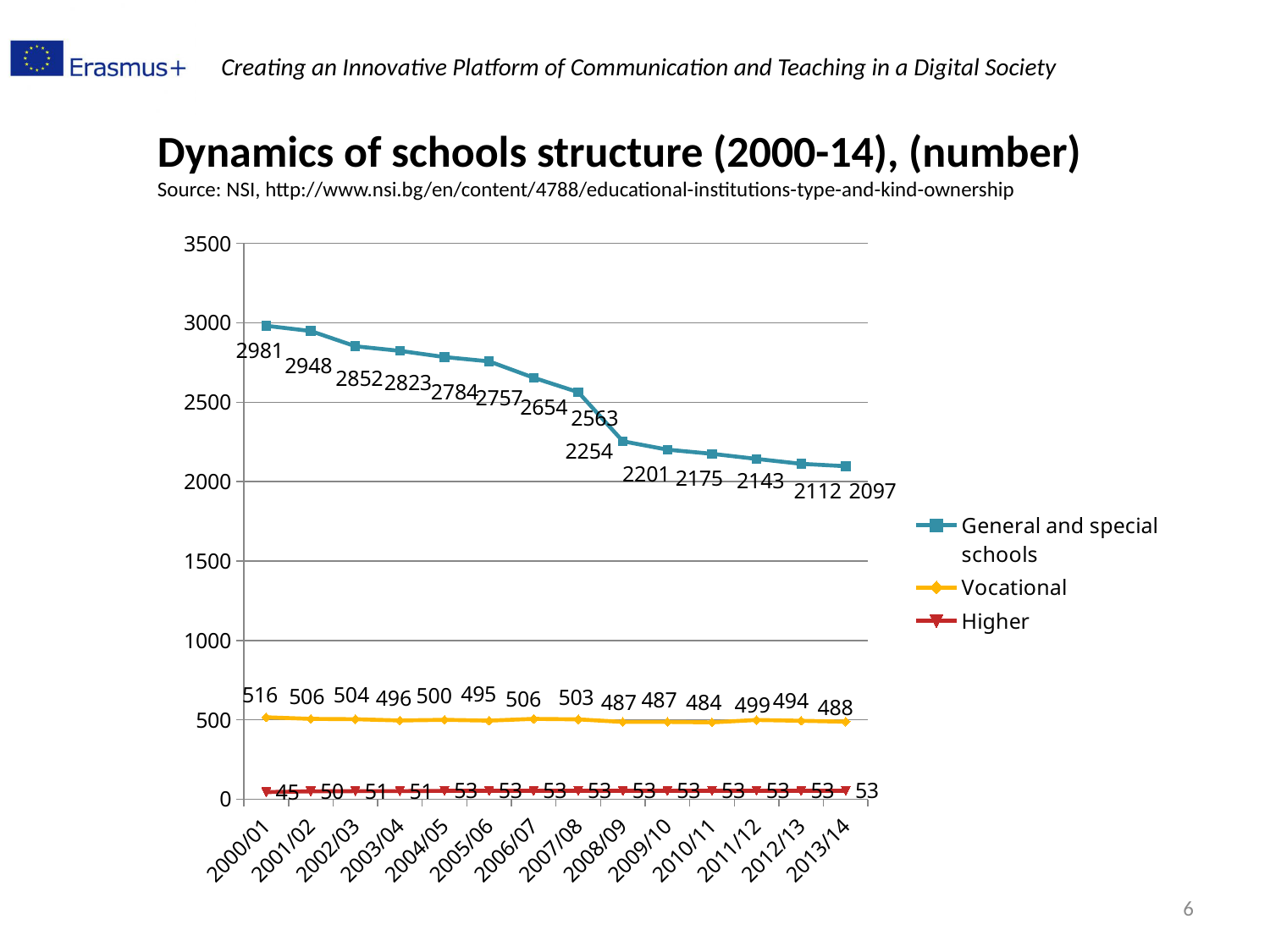
Does the General and special schools series rise or fall from 2000/01 to 2013/14? fall How many school years are plotted along the x axis? 14 What is the value for Higher in 2000/01? 45 What is the difference between the General and special schools values in 2000/01 and 2013/14? 884 In which school year is the value for General and special schools lowest? 2013/14 In which school year is the value for Vocational highest? 2000/01 What is the value for Vocational in 2007/08? 503 Which is larger, the Vocational value in 2006/07 or in 2010/11? 2006/07 What type of chart is shown on the slide? line chart What is the title of the chart? Dynamics of schools structure (2000-14), (number) What is the value for General and special schools in 2000/01? 2981 How many series does the legend list? 3